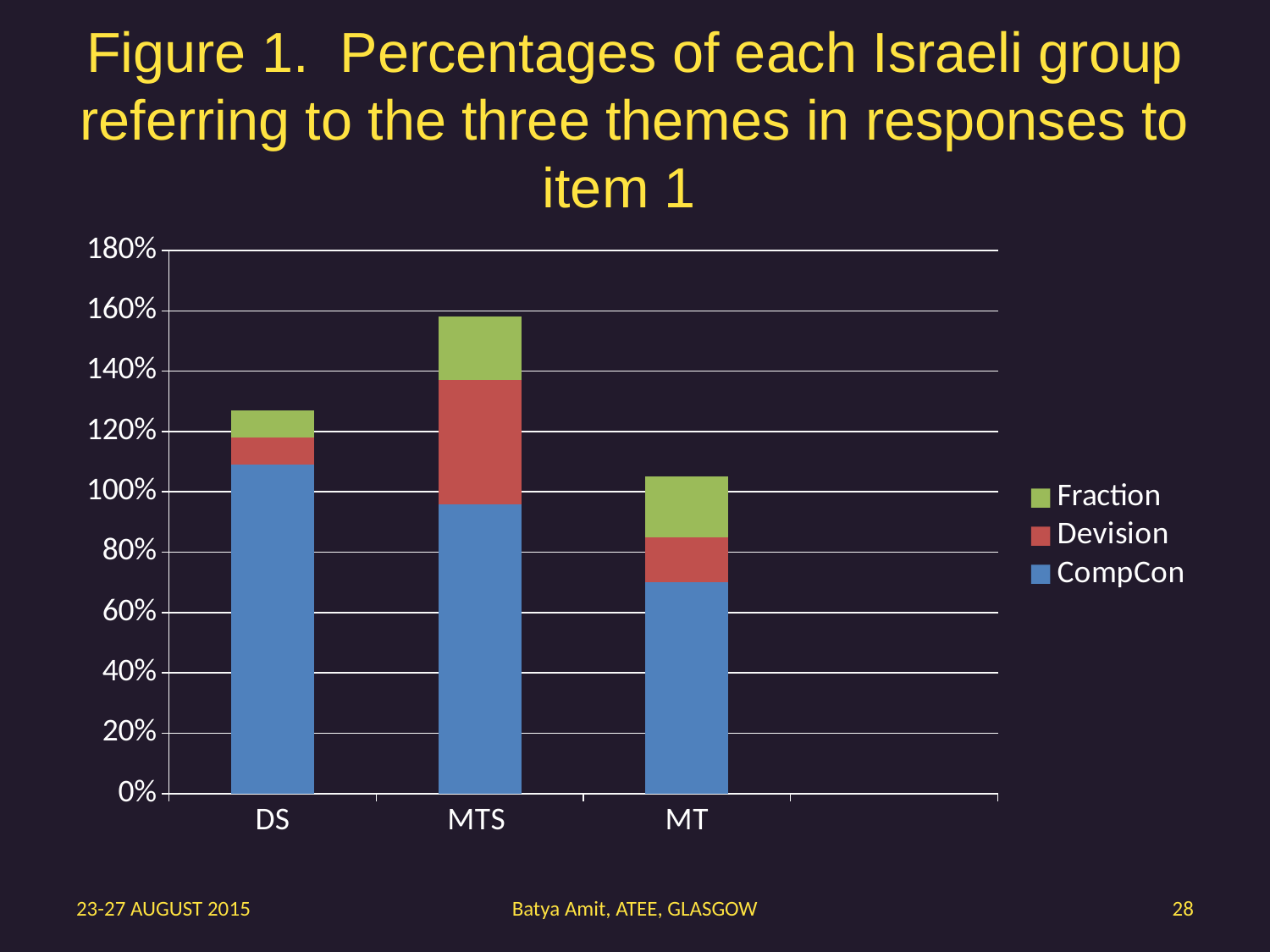
Is the total stacked value for MTS greater or less than 140%? greater Which group has the tallest stacked bar overall? MTS How many series does the chart's legend list? 3 What kind of chart is shown on the slide? stacked bar chart Which series is shown in green in the legend? Fraction Which group has the shortest stacked bar overall? MT How many groups (categories) are shown on the x axis of the chart? 3 Which group has the larger Devision segment, MTS or DS? MTS Which series appears at the bottom of each stacked bar? CompCon Is the total stacked value for DS greater or less than 120%? greater Is the CompCon value for MT greater or less than 80%? less